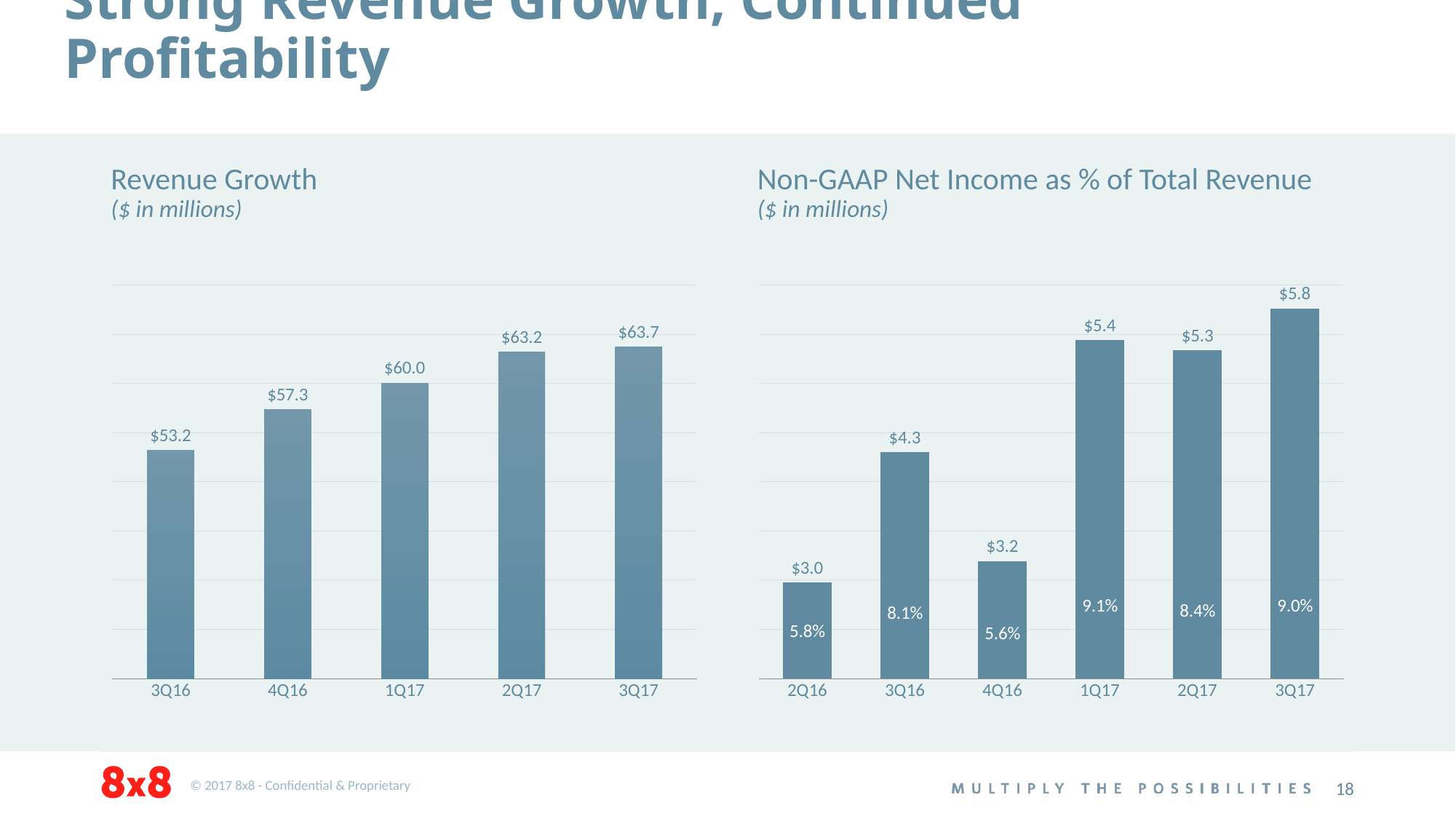
In the Revenue Growth chart, what is the value for 1Q17? $60.0 In the Revenue Growth chart, which quarter has the lowest revenue? 3Q16 In the Non-GAAP Net Income as % of Total Revenue chart, which is larger, the value for 1Q17 or 2Q17? 1Q17 In the Non-GAAP Net Income as % of Total Revenue chart, what percentage is shown for 1Q17? 9.1% In the Non-GAAP Net Income as % of Total Revenue chart, how many quarters are shown? 6 In the Non-GAAP Net Income as % of Total Revenue chart, which quarter has the lowest dollar value? 2Q16 In the Revenue Growth chart, do the values rise or fall from 3Q16 to 3Q17? rise In the Revenue Growth chart, which quarter has the highest revenue? 3Q17 What type of chart is the Revenue Growth chart? bar chart In the Revenue Growth chart, what is the difference between the 3Q17 and 3Q16 values? $10.5 In the Non-GAAP Net Income as % of Total Revenue chart, what is the dollar value for 3Q16? $4.3 In the Revenue Growth chart, how many quarters are shown? 5